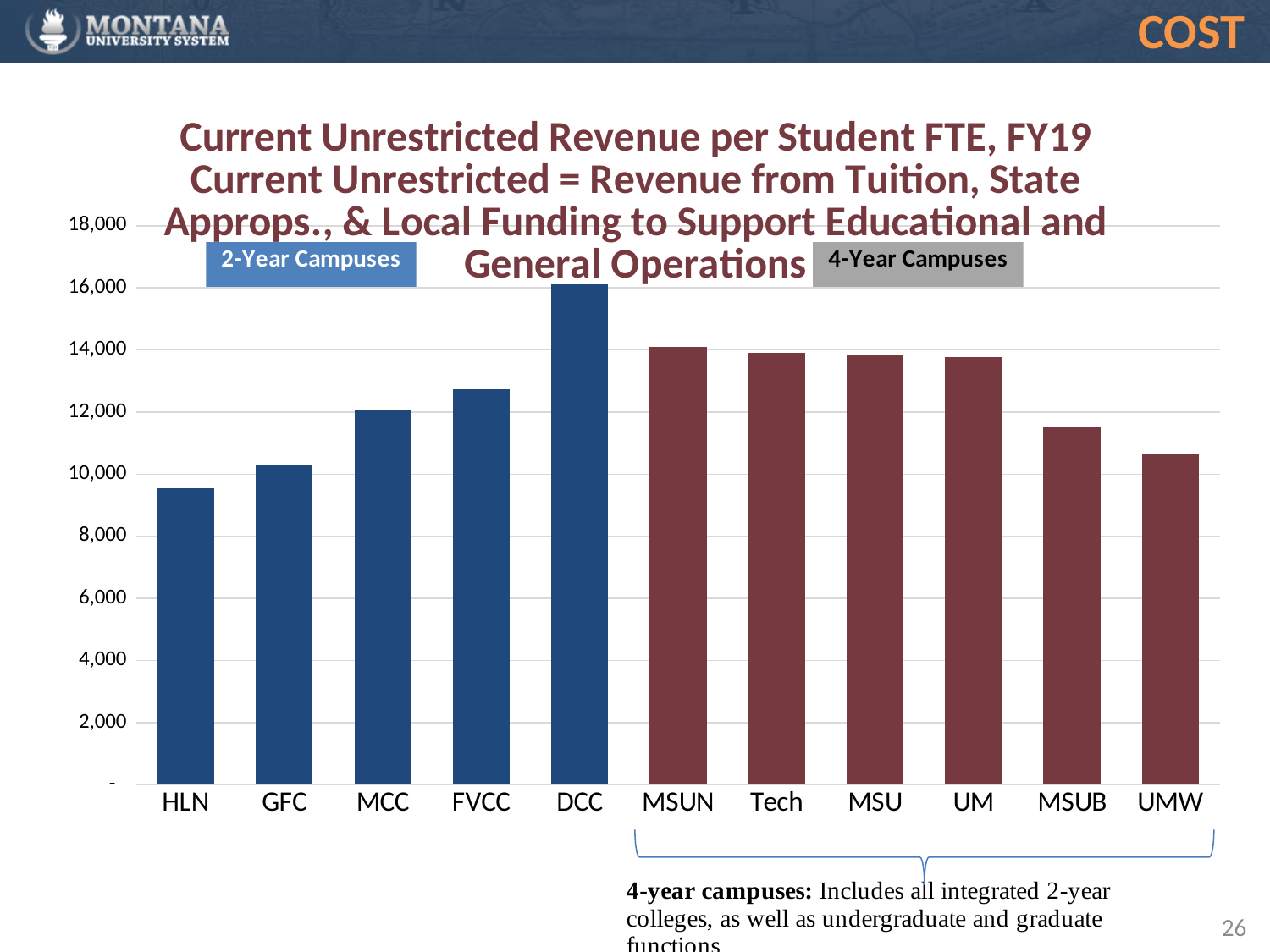
Is the value for FVCC greater or less than 12,000? greater Which campus has the lowest current unrestricted revenue per student FTE? HLN Is the value for UMW greater or less than 10,000? greater Which has a higher value, DCC or MSUN? DCC How many campuses are shown on the x axis of the chart? 11 What colour are the bars for the 2-year campuses? blue Which campus has the highest current unrestricted revenue per student FTE? DCC Is the value for DCC greater or less than 14,000? greater What kind of chart is shown on the slide? bar chart Do the values for the 2-year campuses rise or fall from HLN to DCC? rise